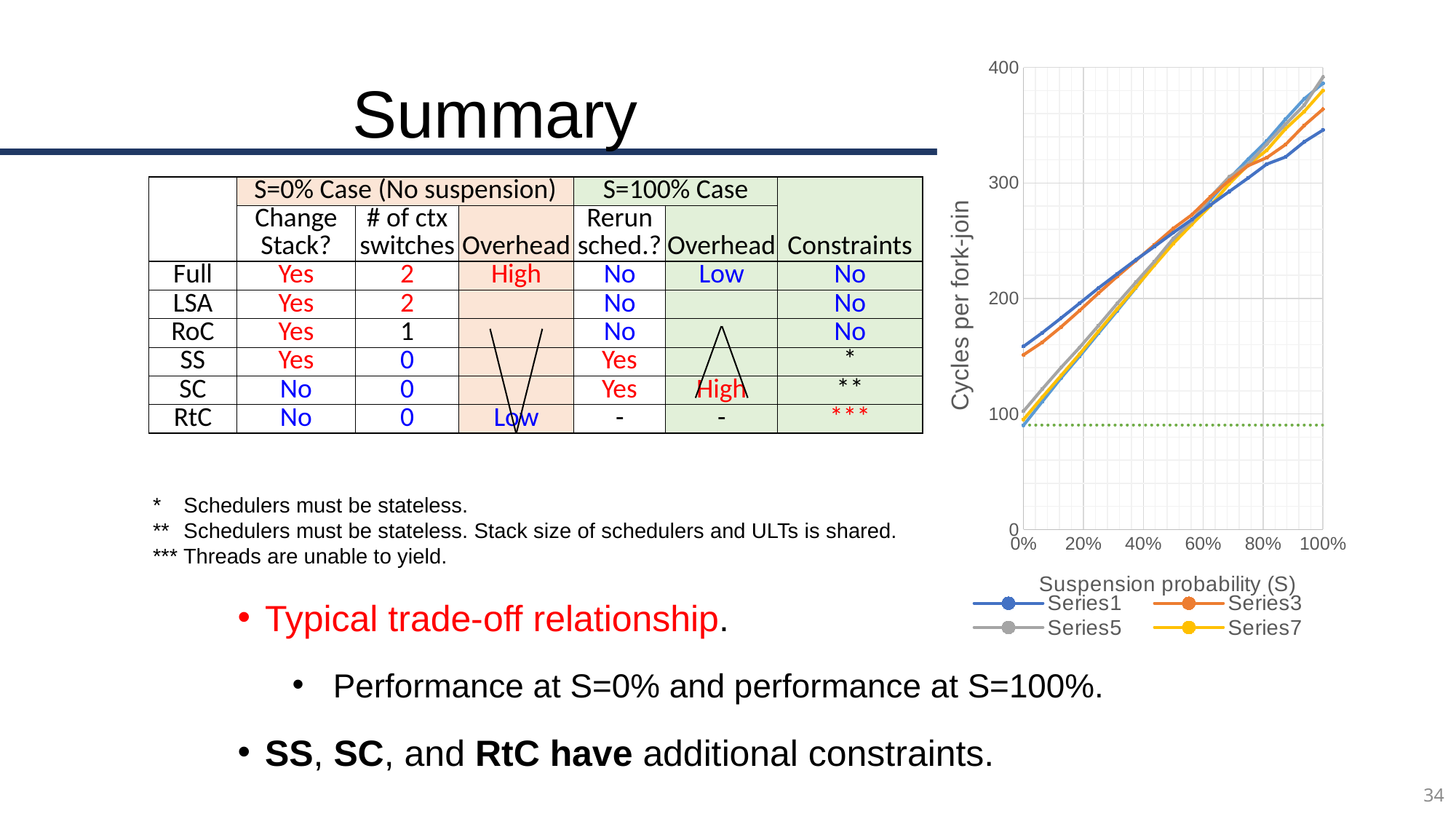
What is the title of the x axis of the chart? Suspension probability (S) Is the value for Series1 at 100% suspension probability greater or less than 300? greater What is the title of the y axis of the chart? Cycles per fork-join What is the highest value labelled on the y axis of the chart? 400 Is the value for Series3 at 0% suspension probability greater or less than 200? less Is the value for Series1 at 0% suspension probability greater or less than 100? greater Do the values of Series1 rise or fall as the suspension probability increases from 0% to 100%? rise How many tick labels are shown on the x axis of the chart? 6 How many series does the legend of the chart list? 4 What kind of chart is shown on the right side of the slide? line chart